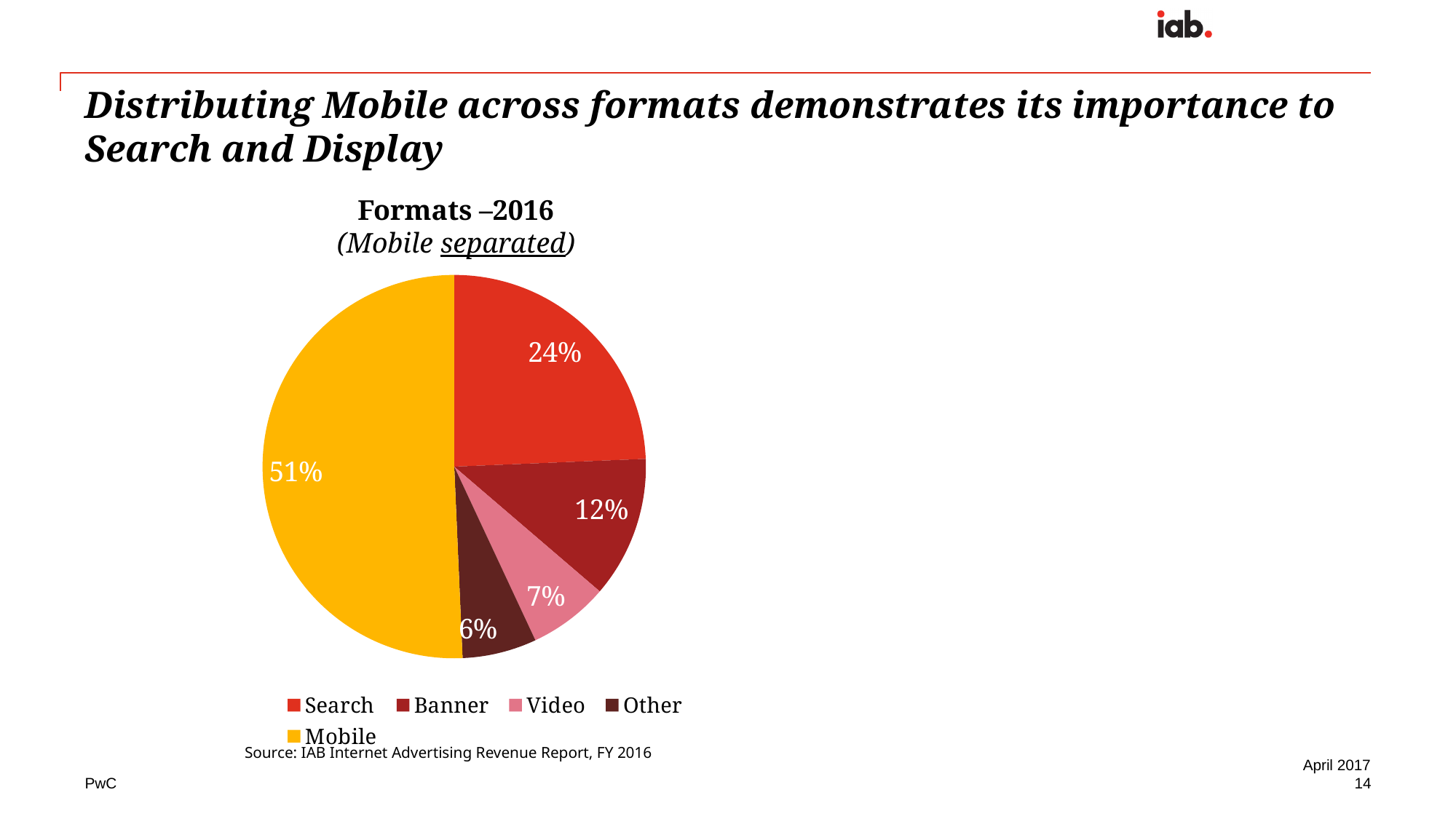
What share of the pie does Video account for? 7% What kind of chart is shown on the slide? Pie chart What share of the pie does Search account for? 24% What share of the pie does Mobile account for? 51% What is the difference in percentage points between the Mobile and Search slices? 27 Which slice is larger, Banner or Video? Banner What is the title of the chart? Formats –2016 (Mobile separated) What share of the pie does Other account for? 6% Which format has the largest slice of the pie? Mobile How many slices does the pie chart have? 5 What share of the pie does Banner account for? 12% Which format has the smallest slice of the pie? Other